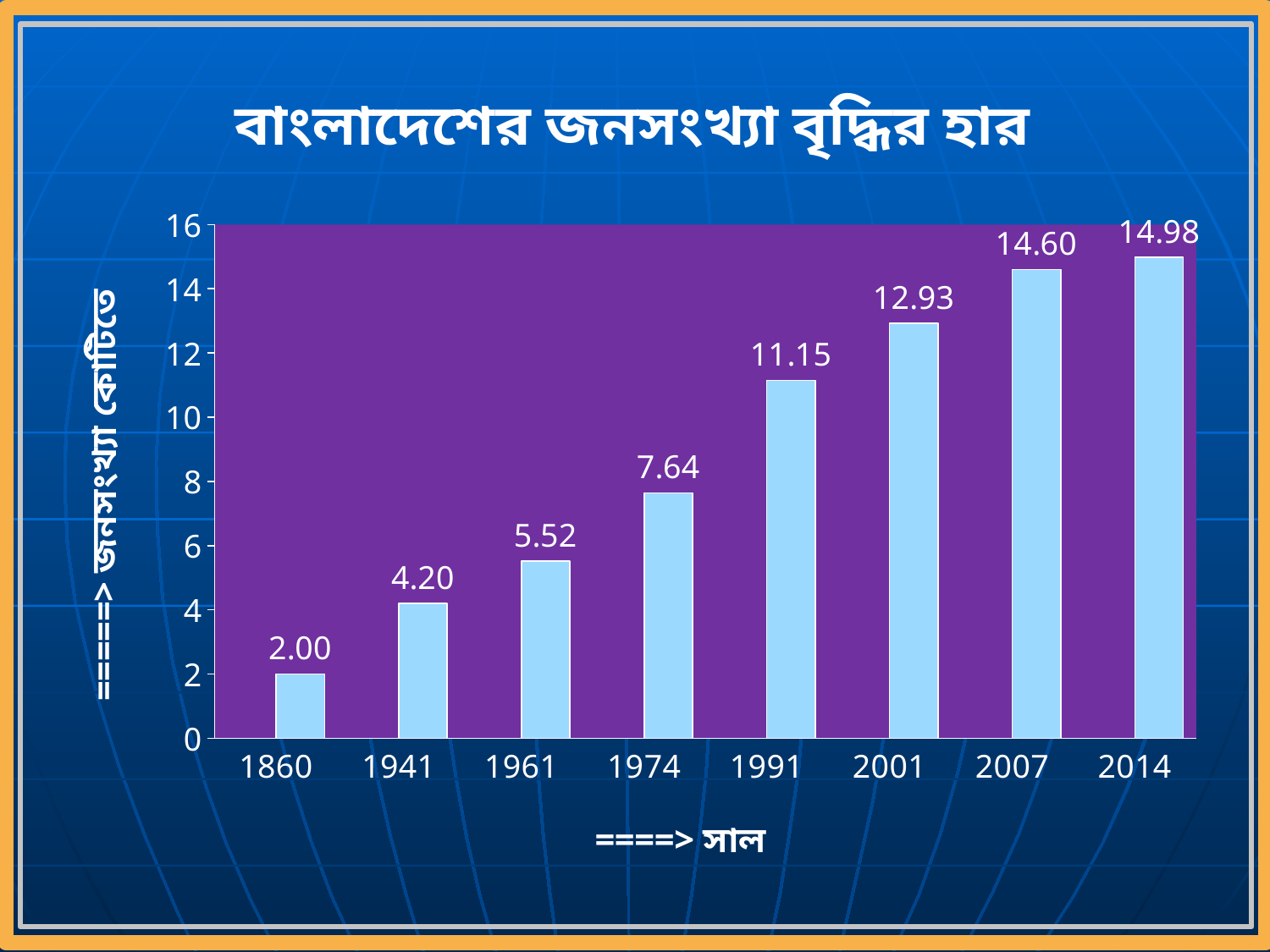
What kind of chart is shown on the slide? bar chart Is the value for 2001 greater or less than 12? greater Which year has the lowest value? 1860 What is the difference between the values for 1974 and 1961? 2.12 Do the values rise or fall from 1860 to 2014? rise What is the value for 1991? 11.15 Which is larger, the value for 1941 or the value for 1961? 1961 How many years are shown on the x axis? 8 What is the value for 2007? 14.60 What is the value for 1860? 2.00 Which year has the highest value? 2014 What is the difference between the values for 2014 and 2001? 2.05